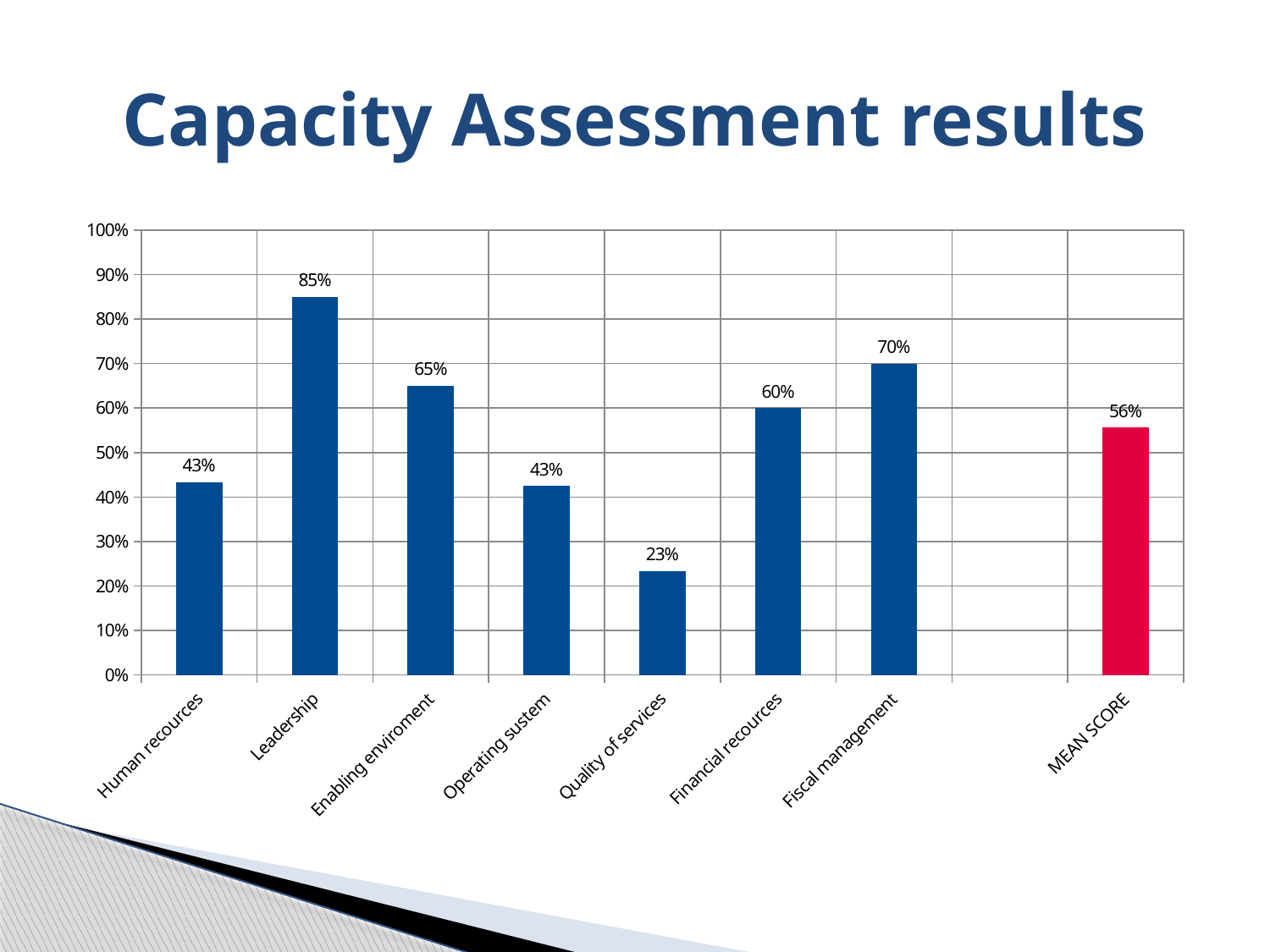
What is the value for Quality of services? 23% Which category has the lowest value? Quality of services What kind of chart is shown on the slide? bar chart Which bar is shown in a different colour (red) from the others? MEAN SCORE Which category has the highest value? Leadership Is the value for Human recources greater or less than 50%? less Which is larger, the value for Financial recources or the value for Fiscal management? Fiscal management How many bars are plotted on the chart? 8 What is the difference between the values for Leadership and Enabling enviroment? 20% What is the value for Leadership? 85% What is the value for Fiscal management? 70% What is the MEAN SCORE shown on the chart? 56%